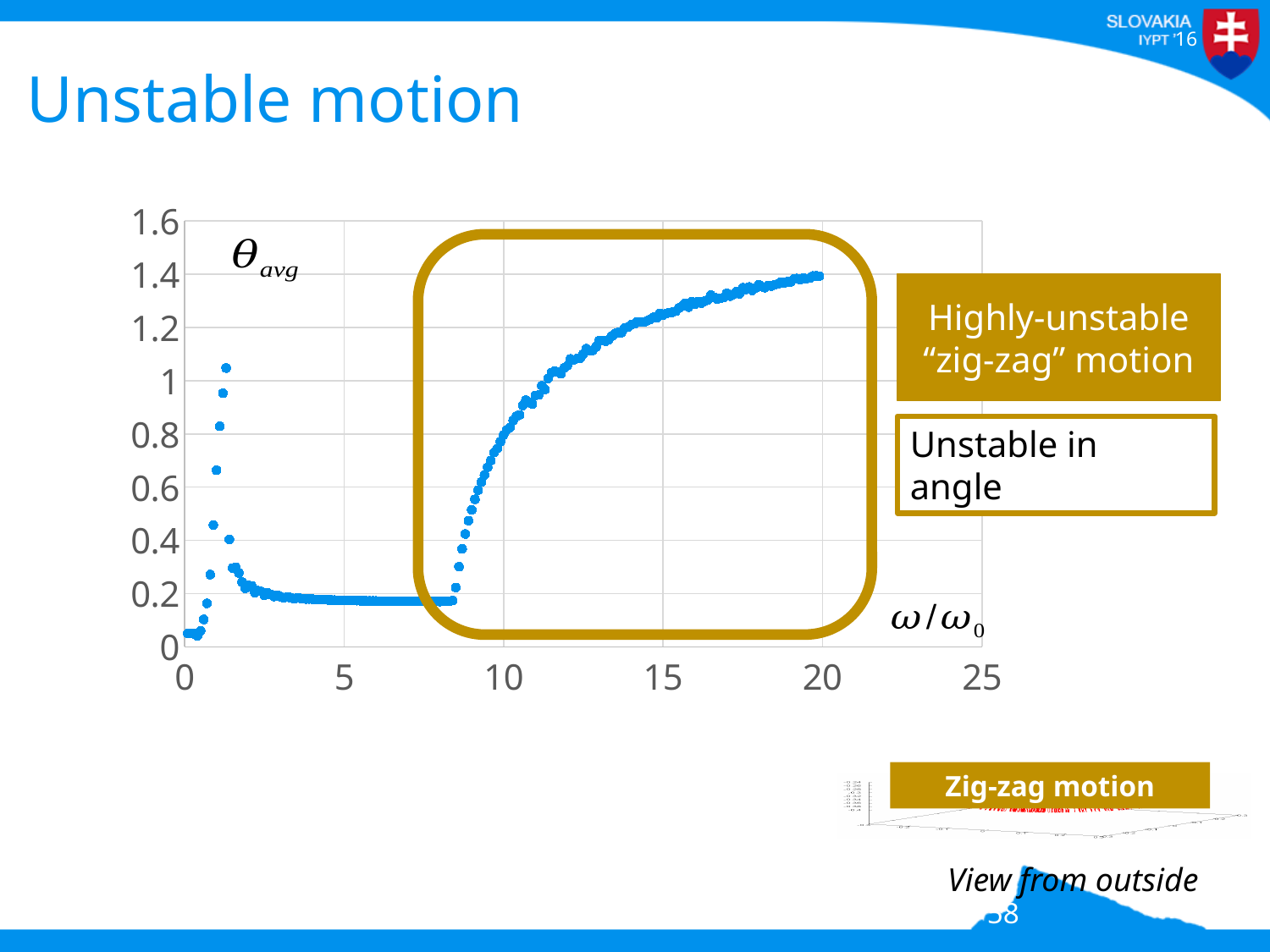
Between ω/ω0 = 10 and ω/ω0 = 20, do the plotted values rise or fall? rise Is the value of θ_avg at ω/ω0 = 20 greater or less than 1.2? greater Is the value of θ_avg at ω/ω0 = 15 greater or less than 1? greater Is the value of θ_avg at ω/ω0 = 20 larger or smaller than the value at ω/ω0 = 5? larger What kind of chart is shown on the slide? scatter chart Is the value of θ_avg at ω/ω0 = 5 greater or less than 0.4? less What quantity is labelled on the horizontal axis of the chart? ω/ω0 Between ω/ω0 = 2 and ω/ω0 = 5, do the plotted values rise or fall? fall What quantity is labelled on the vertical axis of the chart? θ_avg How many data series are plotted on the chart? 1